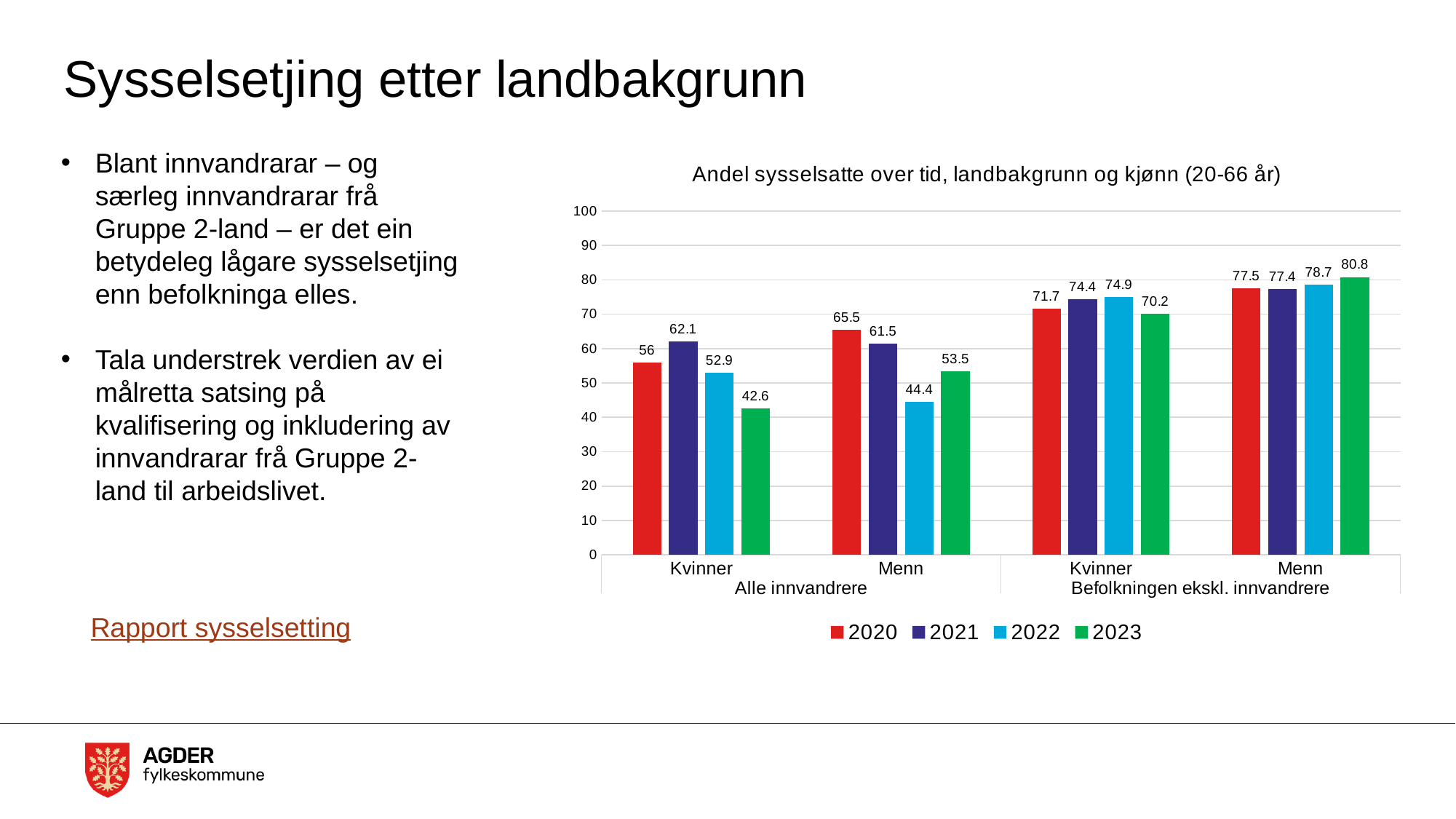
How many categories are shown on the x axis? 4 What is the title of the chart? Andel sysselsatte over tid, landbakgrunn og kjønn (20-66 år) How many series does the legend list? 4 What is the value for 2023 for Kvinner among Alle innvandrere? 42.6 Which is larger: the 2021 value for Kvinner among Alle innvandrere or the 2021 value for Menn among Alle innvandrere? Kvinner, Alle innvandrere Which category has the highest value for 2023? Menn, Befolkningen ekskl. innvandrere What kind of chart is shown on the slide? Bar chart Do the values for Menn in Befolkningen ekskl. innvandrere rise or fall from 2022 to 2023? Rise What is the difference between the 2023 values for Menn in Befolkningen ekskl. innvandrere and Menn among Alle innvandrere? 27.3 Which category has the lowest value for 2022? Menn, Alle innvandrere What is the value for 2020 for Menn among Alle innvandrere? 65.5 What is the value for 2022 for Kvinner in Befolkningen ekskl. innvandrere? 74.9